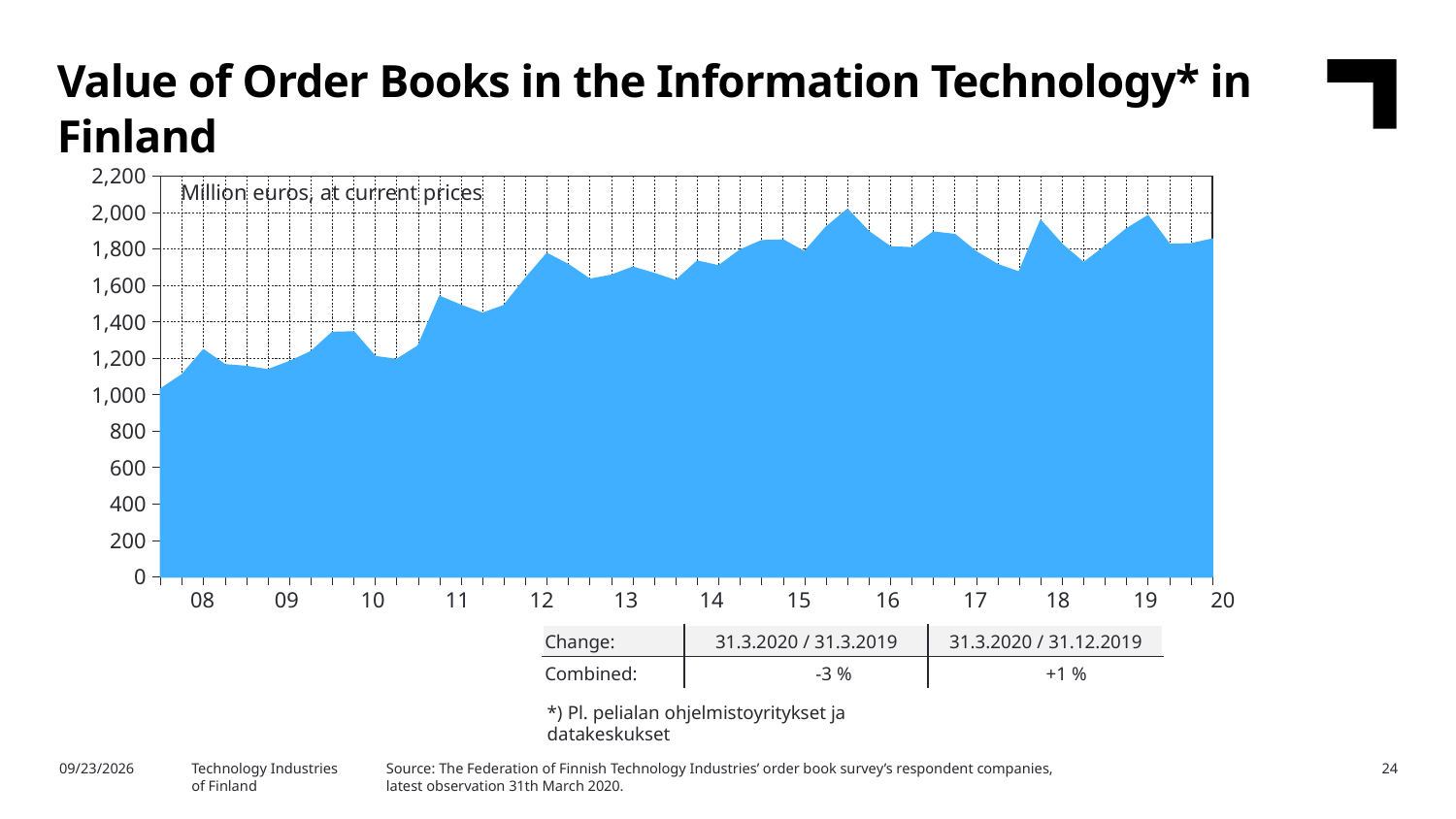
What kind of chart is shown on the slide? Area chart What is the highest value shown on the vertical axis of the chart? 2,200 What is the combined change in order books for 31.3.2020 compared with 31.3.2019? -3 % Is the value of order books at the start of 2014 greater or less than 1,400? greater Is the value of order books at the start of 2020 greater or less than 1,600? greater Is the value of order books at the start of 2008 greater or less than 1,400? less What unit is the value of order books measured in, according to the label inside the chart? Million euros, at current prices Overall, do the values of order books rise or fall from 2008 to 2020? Rise What is the combined change in order books for 31.3.2020 compared with 31.12.2019? +1 %